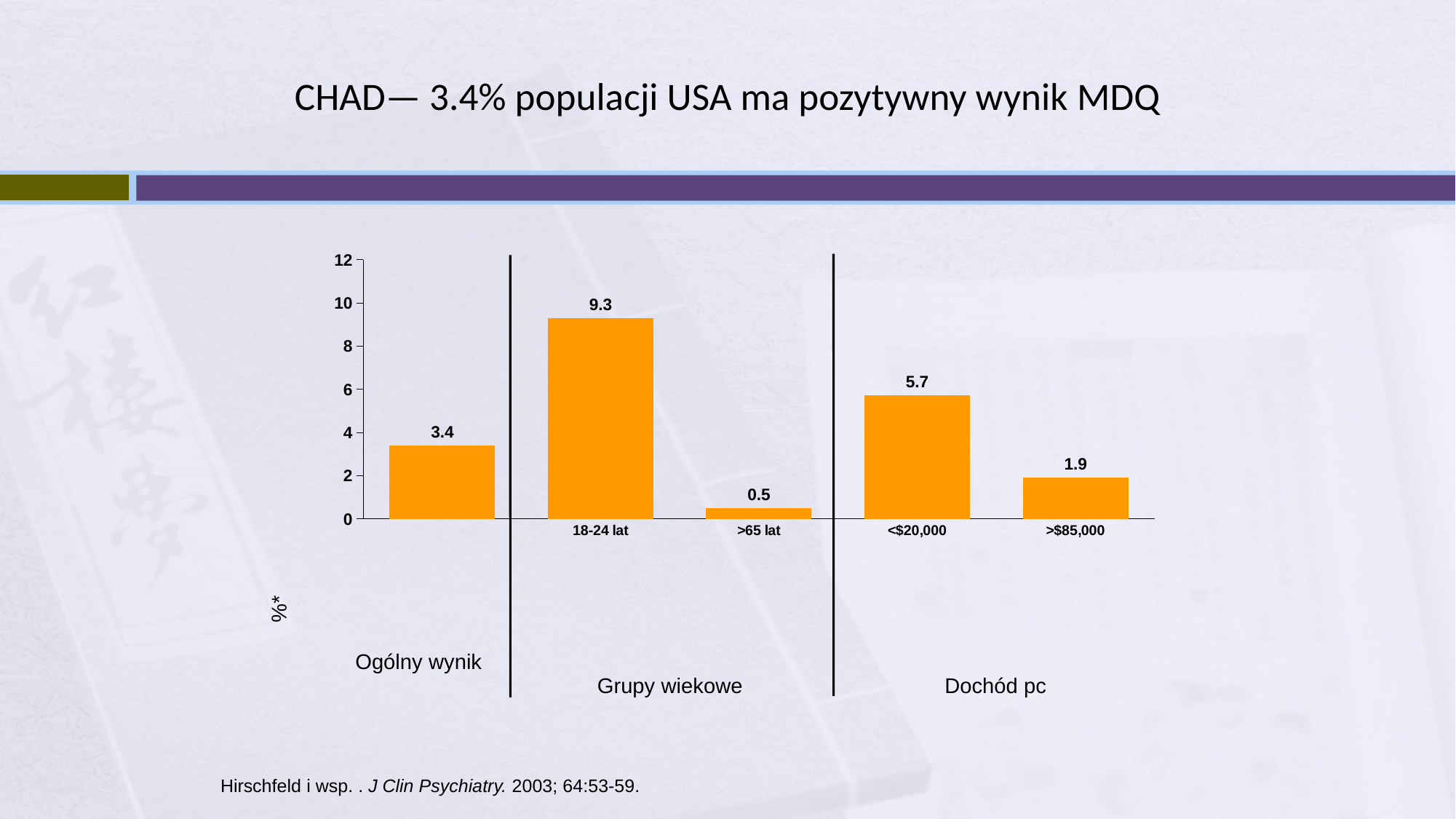
What is the difference between the <$20,000 and >$85,000 values? 3.8 Which is larger, the value for <$20,000 or the value for Ogólny wynik? <$20,000 What is the value for the >65 lat bar? 0.5 What kind of chart is shown on the slide? Bar chart How many bars are plotted on the chart? 5 Which bar has the highest value? 18-24 lat What is the difference between the 18-24 lat and >65 lat values? 8.8 What is the value for the <$20,000 bar? 5.7 What is the value of the Ogólny wynik bar? 3.4 What is the value for the >$85,000 bar? 1.9 Which bar has the lowest value? >65 lat What is the value for the 18-24 lat bar? 9.3